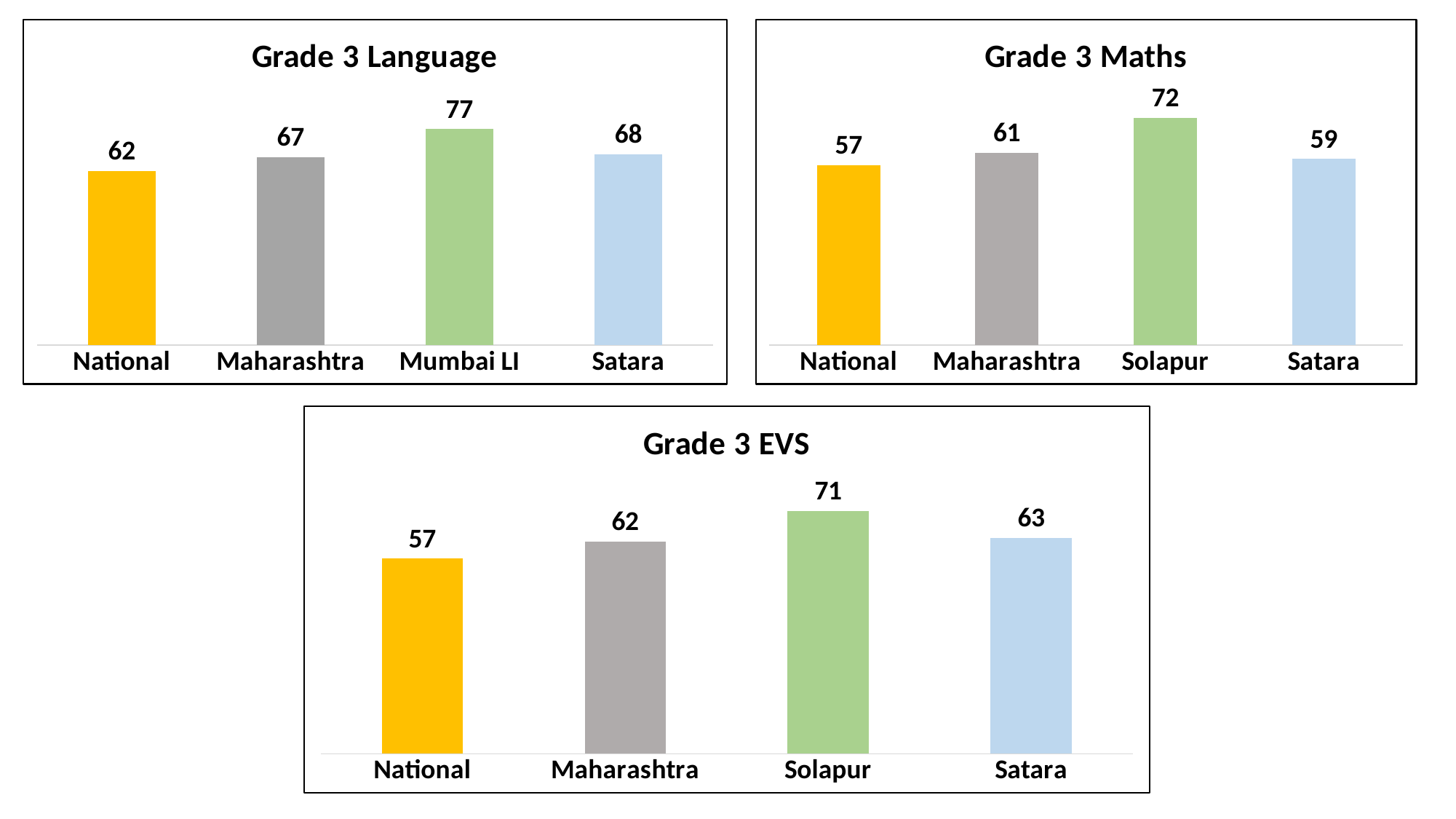
In the Grade 3 EVS chart, which is larger, the value for Maharashtra or the value for Satara? Satara In the Grade 3 Language chart, what is the difference between the values for Mumbai LI and National? 15 In the Grade 3 Maths chart, what is the value for National? 57 In the Grade 3 Maths chart, which category has the lowest value? National In the Grade 3 EVS chart, which category has the highest value? Solapur In the Grade 3 Language chart, what is the value for Mumbai LI? 77 What kind of chart is the Grade 3 EVS chart? Bar chart In the Grade 3 Language chart, which category has the highest value? Mumbai LI In the Grade 3 EVS chart, what is the value for Satara? 63 In the Grade 3 Maths chart, what is the difference between the values for Solapur and Satara? 13 How many categories are shown in the Grade 3 Maths chart? 4 In the Grade 3 Language chart, what colour is the bar for Mumbai LI? Green